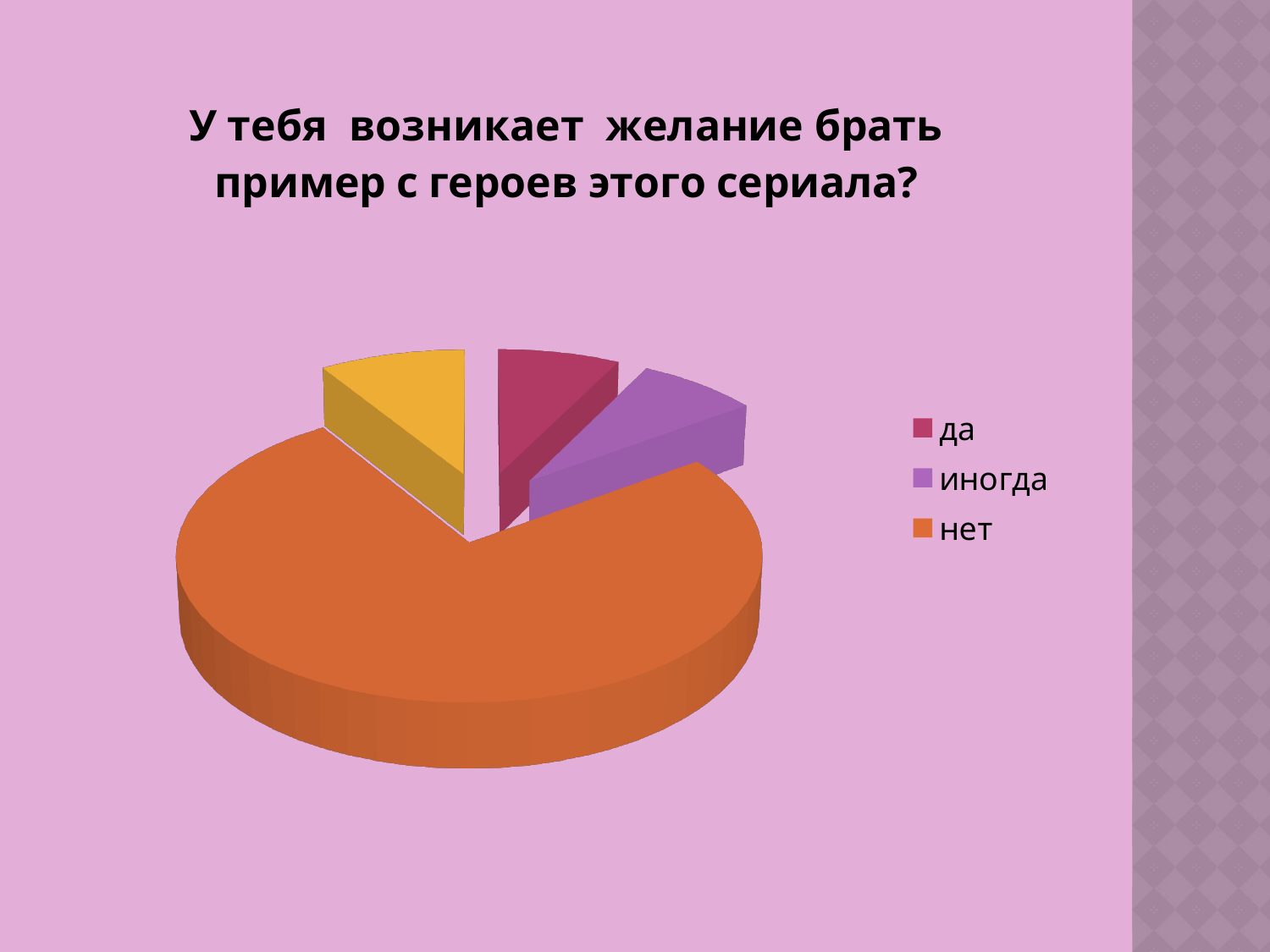
Which category has the largest slice in the pie chart? нет What colour is the "нет" slice in the pie chart? orange Which slice is larger in the pie chart, "нет" or "да"? нет What is the title of the chart on the slide? У тебя возникает желание брать пример с героев этого сериала? How many entries does the legend of the pie chart list? 3 Which slice is larger in the pie chart, "нет" or "иногда"? нет What kind of chart is shown on the slide? pie chart